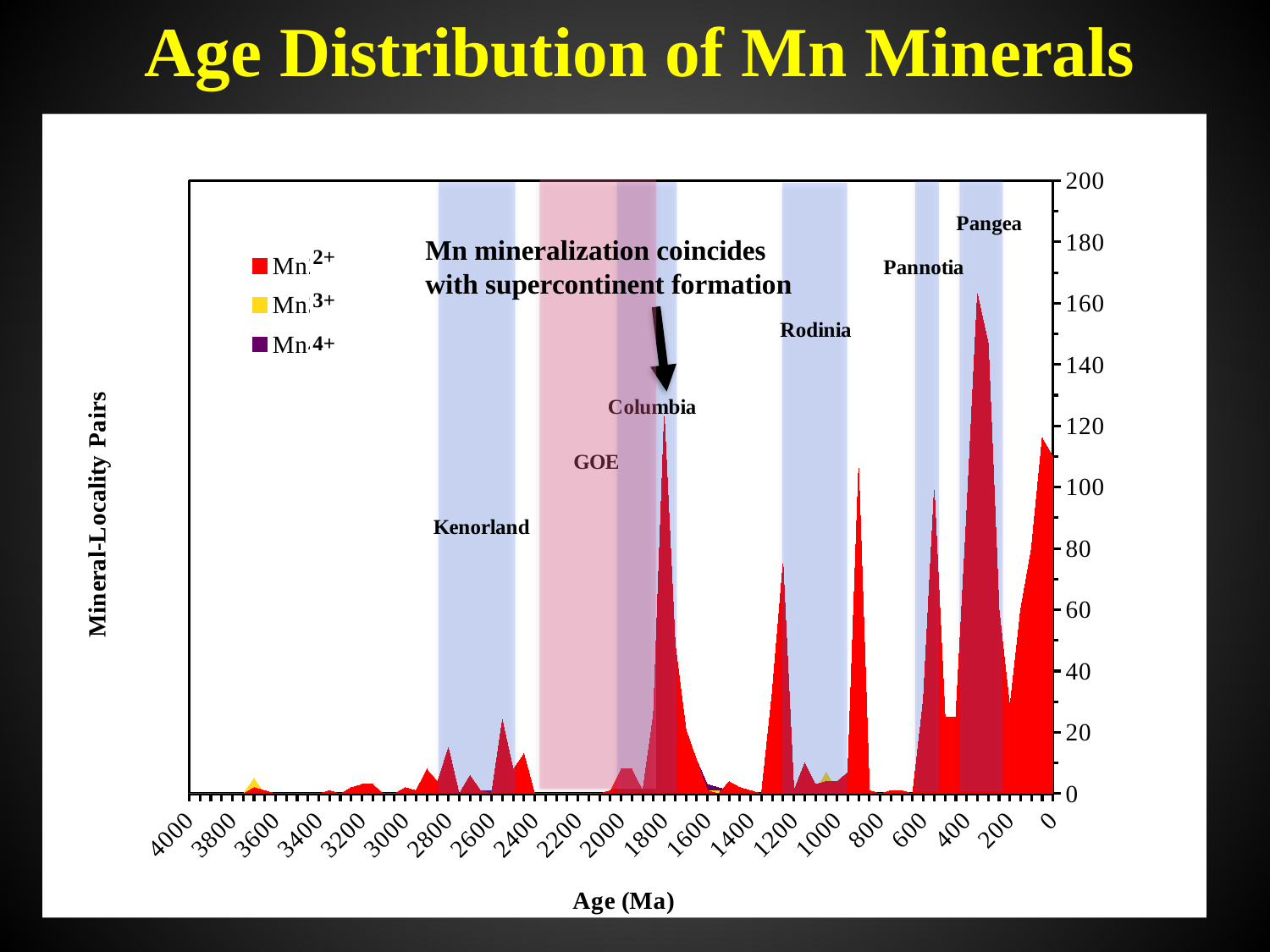
What is the label of the x axis? Age (Ma) Is the highest peak of the Mn2+ series, near 300 Ma, greater or less than 140 mineral-locality pairs? greater How many series does the legend list? 3 Is the Mn2+ value at 0 Ma greater or less than 100 mineral-locality pairs? greater Is the Mn2+ peak near 1750 Ma (labelled Columbia) greater or less than 100 mineral-locality pairs? greater Which supercontinent label is placed next to the tallest peak in the chart? Pangea What is the maximum value shown on the y axis? 200 What is the title of the chart? Age Distribution of Mn Minerals What kind of chart is shown on the slide? Area chart Which is larger: the Mn2+ peak near 300 Ma or the Mn2+ peak near 1200 Ma? The peak near 300 Ma